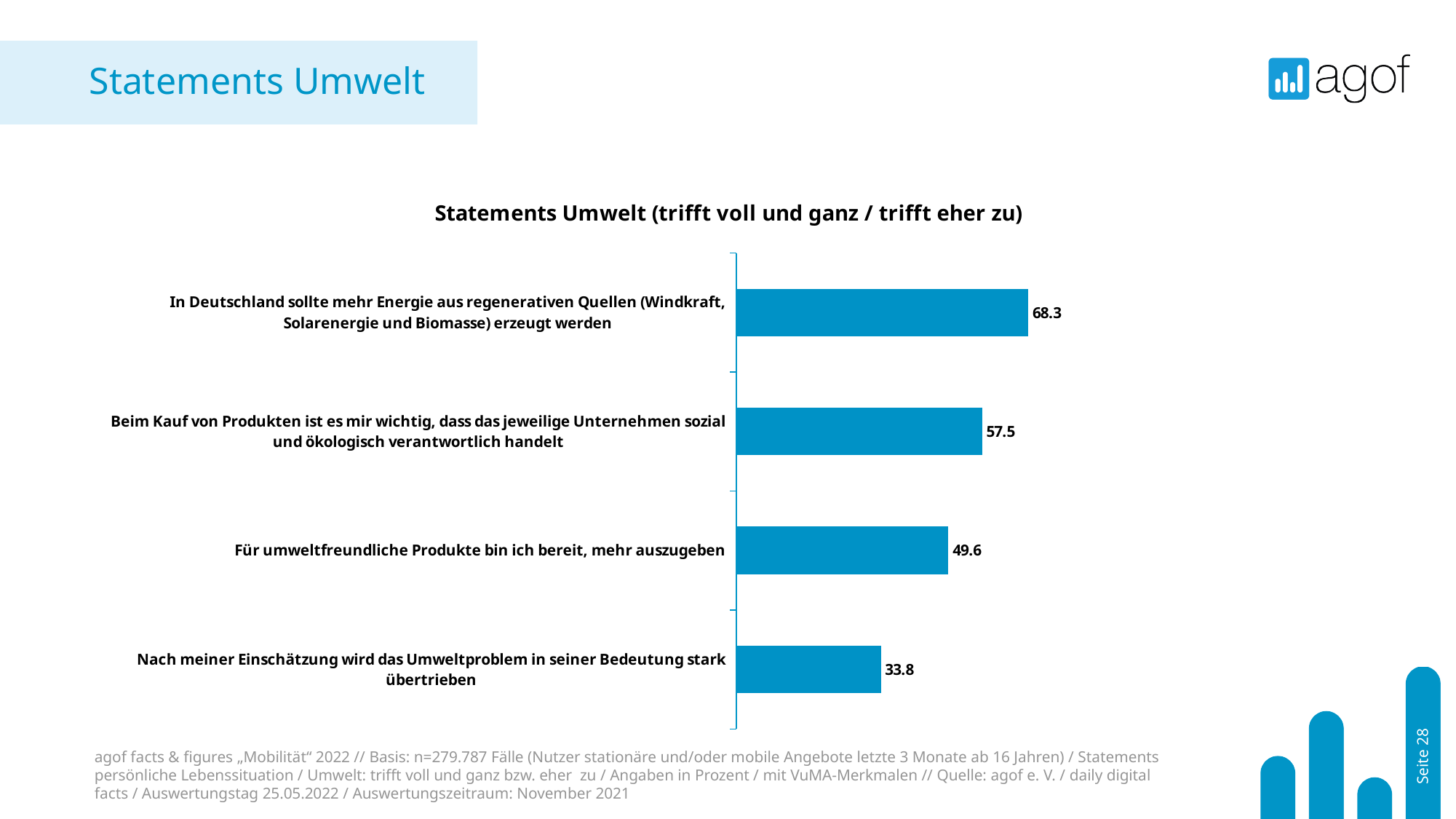
Which is larger: the value for "Für umweltfreundliche Produkte bin ich bereit, mehr auszugeben" or the value for "Nach meiner Einschätzung wird das Umweltproblem in seiner Bedeutung stark übertrieben"? Für umweltfreundliche Produkte bin ich bereit, mehr auszugeben What is the difference between the highest value (68.3) and the lowest value (33.8)? 34.5 How many statements are shown in the chart? 4 What is the value for the statement "Beim Kauf von Produkten ist es mir wichtig, dass das jeweilige Unternehmen sozial und ökologisch verantwortlich handelt"? 57.5 Which statement has the lowest value? Nach meiner Einschätzung wird das Umweltproblem in seiner Bedeutung stark übertrieben What is the value for the statement "Für umweltfreundliche Produkte bin ich bereit, mehr auszugeben"? 49.6 What is the difference between the values for "Beim Kauf von Produkten ist es mir wichtig..." (57.5) and "Für umweltfreundliche Produkte bin ich bereit, mehr auszugeben" (49.6)? 7.9 What is the title of the chart? Statements Umwelt (trifft voll und ganz / trifft eher zu) What colour are the bars in the chart? Blue Which statement has the highest value? In Deutschland sollte mehr Energie aus regenerativen Quellen (Windkraft, Solarenergie und Biomasse) erzeugt werden What is the value for the statement "Nach meiner Einschätzung wird das Umweltproblem in seiner Bedeutung stark übertrieben"? 33.8 What kind of chart is shown on the slide? Bar chart